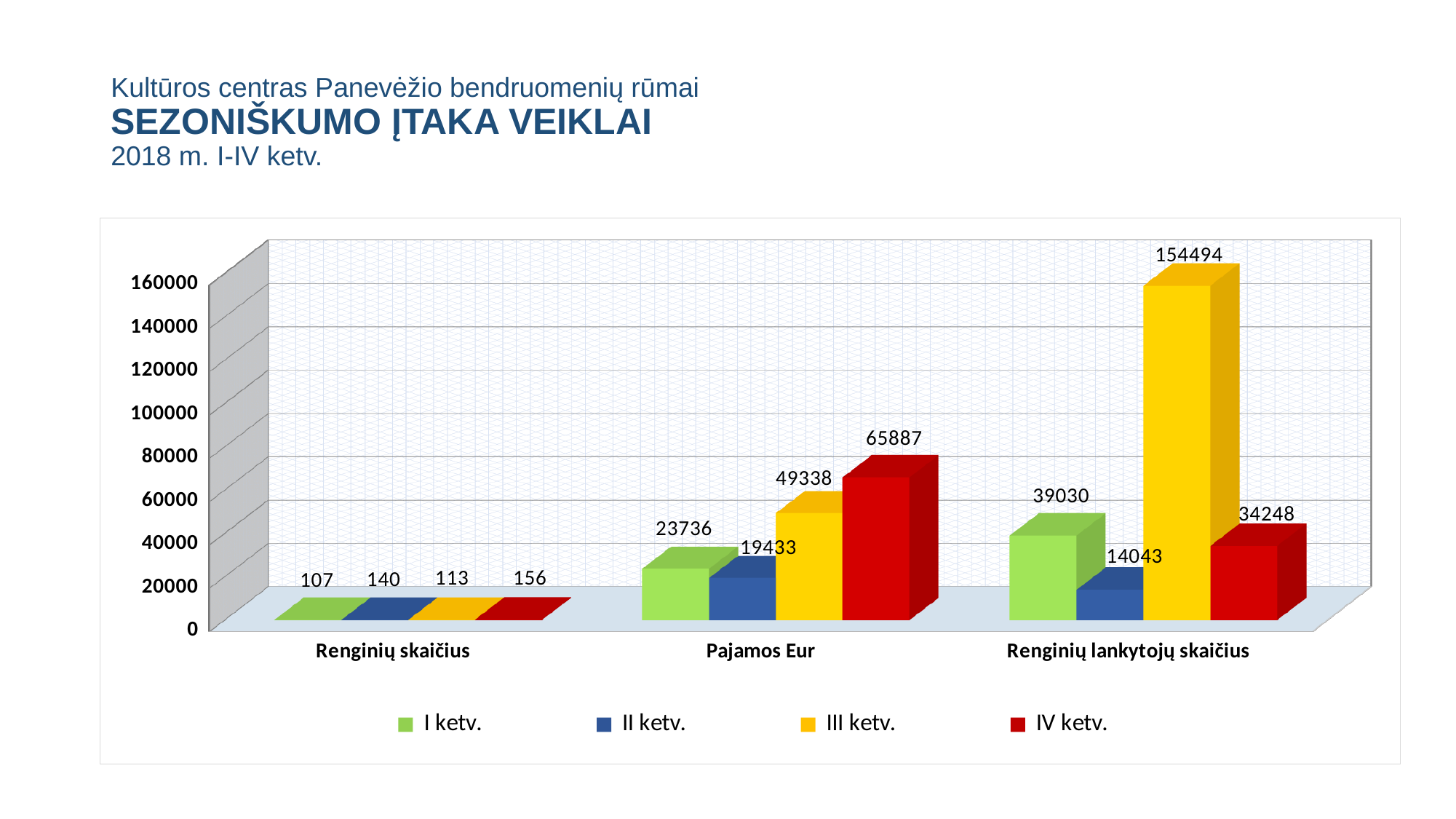
Is the value for III ketv. in the Renginių lankytojų skaičius category greater or less than 140000? greater Which quarter has the lowest value in the Renginių lankytojų skaičius category? II ketv. How many categories are shown on the x axis? 3 How many series does the legend list? 4 What is the difference between the III ketv. and IV ketv. values in the Renginių lankytojų skaičius category? 120246 What is the value for IV ketv. in the Pajamos Eur category? 65887 Which quarter has the highest value in the Pajamos Eur category? IV ketv. What is the value for II ketv. in the Renginių skaičius category? 140 What kind of chart is shown on the slide? bar chart Which colour represents III ketv. in the legend? yellow What is the value for III ketv. in the Renginių lankytojų skaičius category? 154494 Which is larger in the Pajamos Eur category: I ketv. or II ketv.? I ketv.